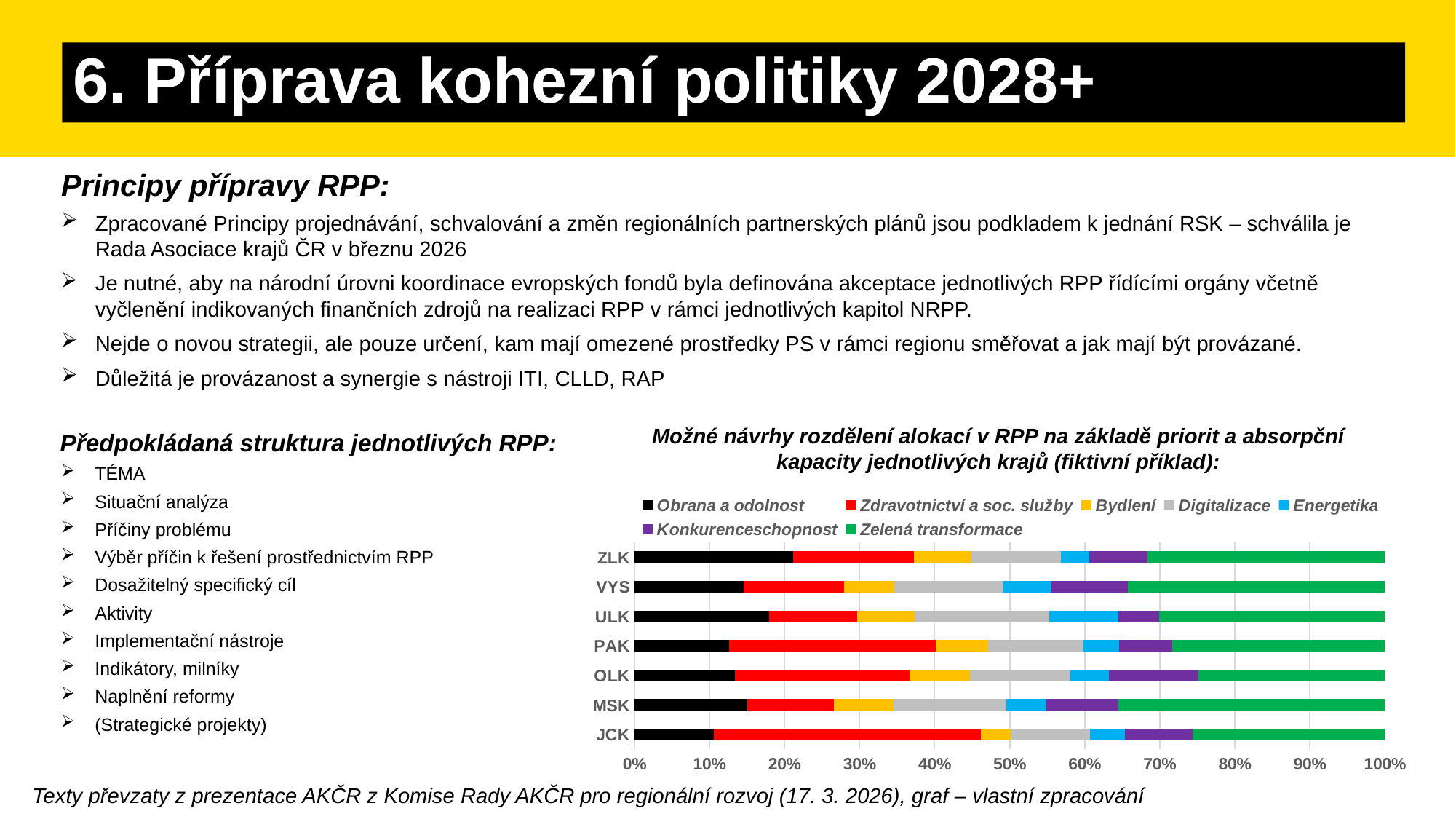
Which series is shown in green in the chart legend? Zelená transformace Is the Obrana a odolnost share for PAK greater or less than 10%? greater Is the Zelená transformace share for JCK greater or less than 30%? less How many series does the chart legend list? 7 How many regions (categories) are plotted on the chart? 7 Is the Obrana a odolnost share for ULK greater or less than 20%? less Which has the larger Obrana a odolnost share, ZLK or JCK? ZLK What kind of chart is shown on the slide? Stacked bar chart Which region has the largest Obrana a odolnost share? ZLK Which category is listed at the top of the chart's vertical axis? ZLK What is the total of the stacked bar for MSK? 100%